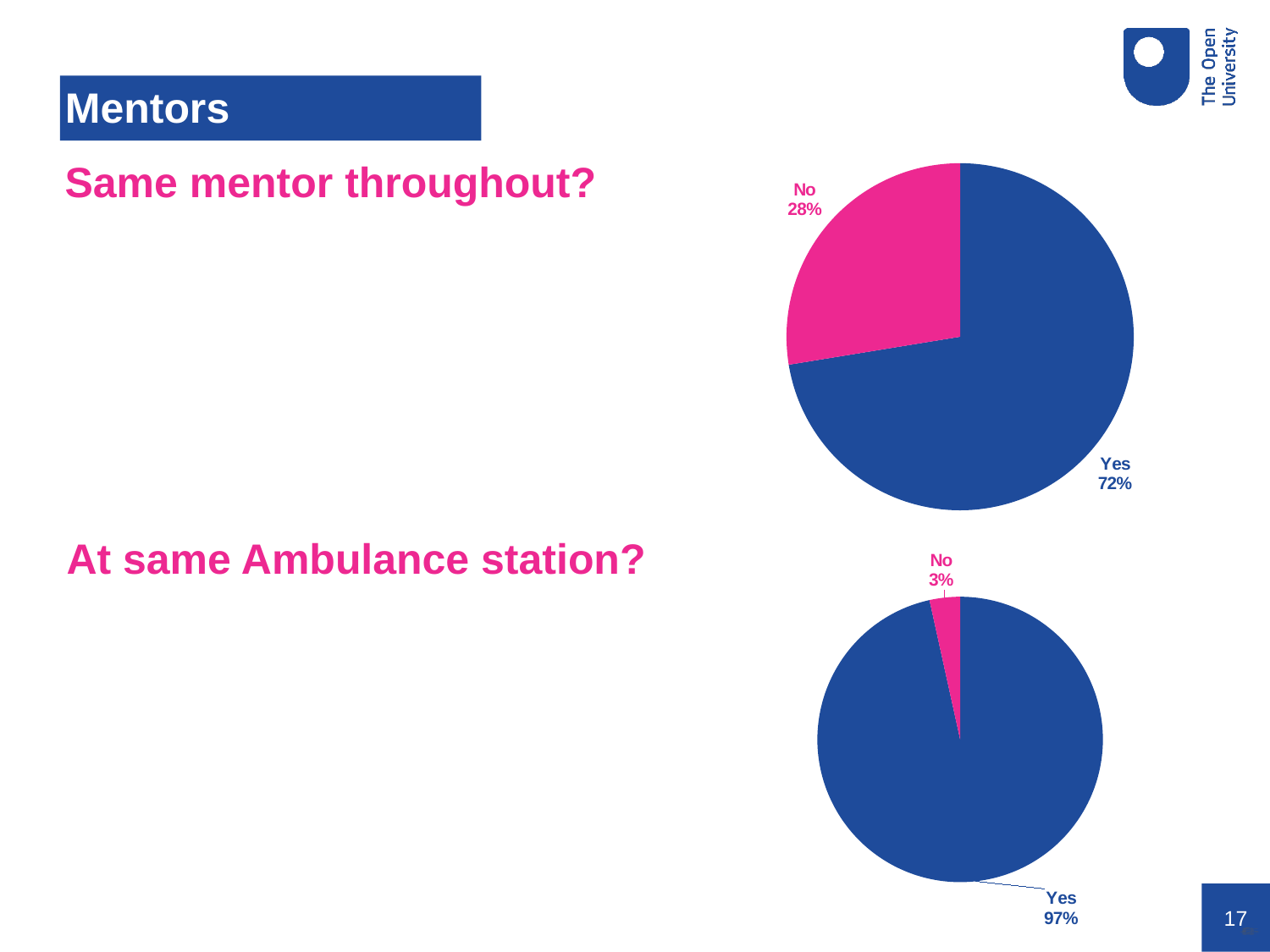
In the 'Same mentor throughout?' pie chart, what percentage answered Yes? 72% In the 'Same mentor throughout?' pie chart, what colour is the No slice? Pink In the 'At same Ambulance station?' pie chart, what percentage answered Yes? 97% In the 'Same mentor throughout?' pie chart, which response has the largest share? Yes In the 'At same Ambulance station?' pie chart, what percentage answered No? 3% What type of chart is used for 'At same Ambulance station?'? Pie chart In the 'Same mentor throughout?' pie chart, what is the difference between the Yes and No percentages? 44% In the 'Same mentor throughout?' pie chart, what percentage answered No? 28% In the 'At same Ambulance station?' pie chart, what is the difference between the Yes and No percentages? 94% Which chart has the larger Yes share, 'Same mentor throughout?' or 'At same Ambulance station?'? At same Ambulance station? In the 'At same Ambulance station?' pie chart, which response has the smallest share? No How many slices does the 'Same mentor throughout?' pie chart have? 2